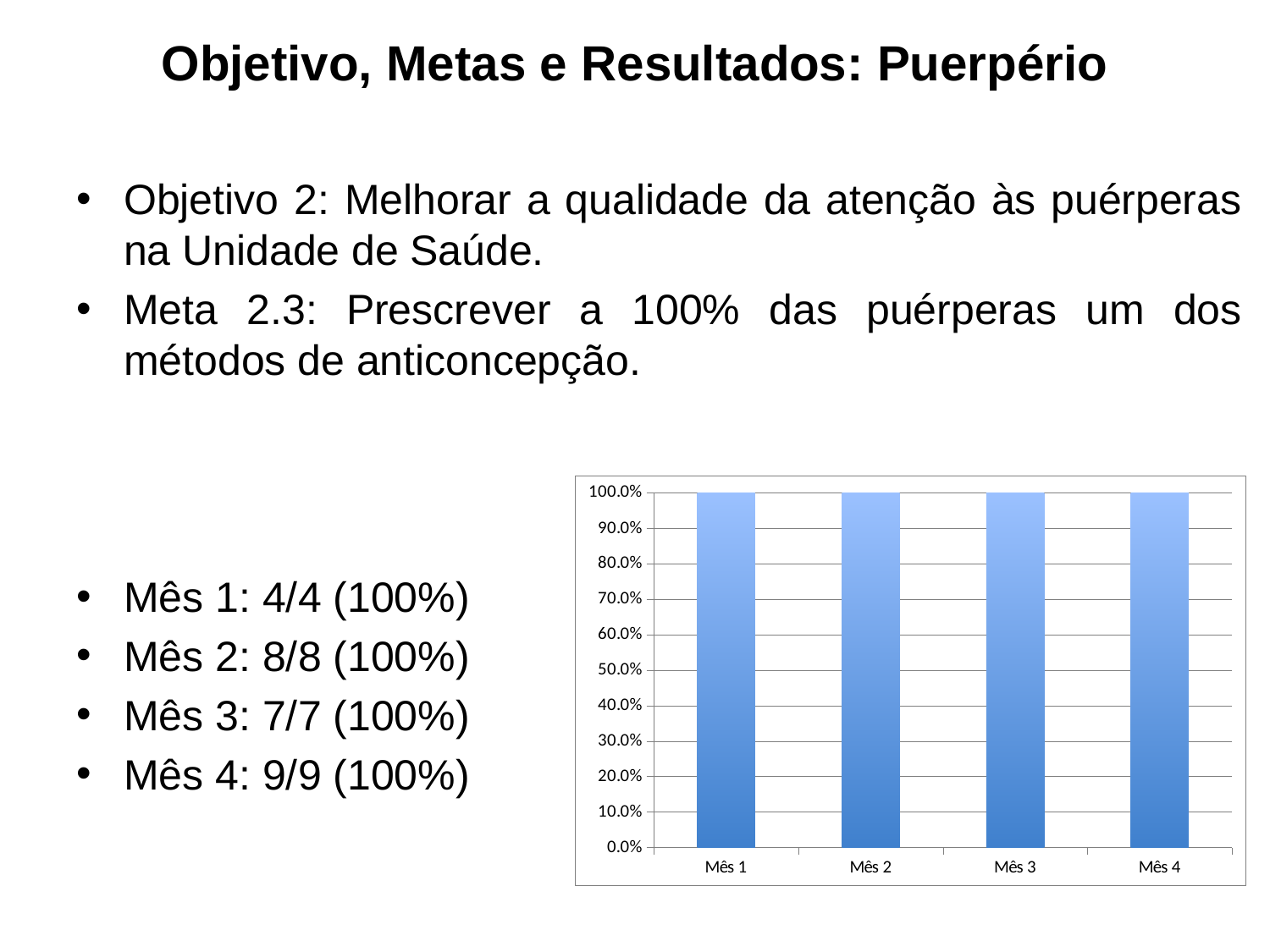
What is the difference between the values for Mês 2 and Mês 3? 0.0% What is the value for Mês 1 in the chart? 100.0% What is the label of the first category on the x axis? Mês 1 Is the value for Mês 2 greater or less than 90.0%? greater Is the value for Mês 4 greater or less than 50.0%? greater Do the values rise, fall or stay the same from Mês 1 to Mês 4? stay the same What is the highest value shown on the y axis of the chart? 100.0% How many categories are shown on the x axis of the chart? 4 What is the value for Mês 4 in the chart? 100.0% What kind of chart is shown on the slide? bar chart What is the value for Mês 3 in the chart? 100.0%